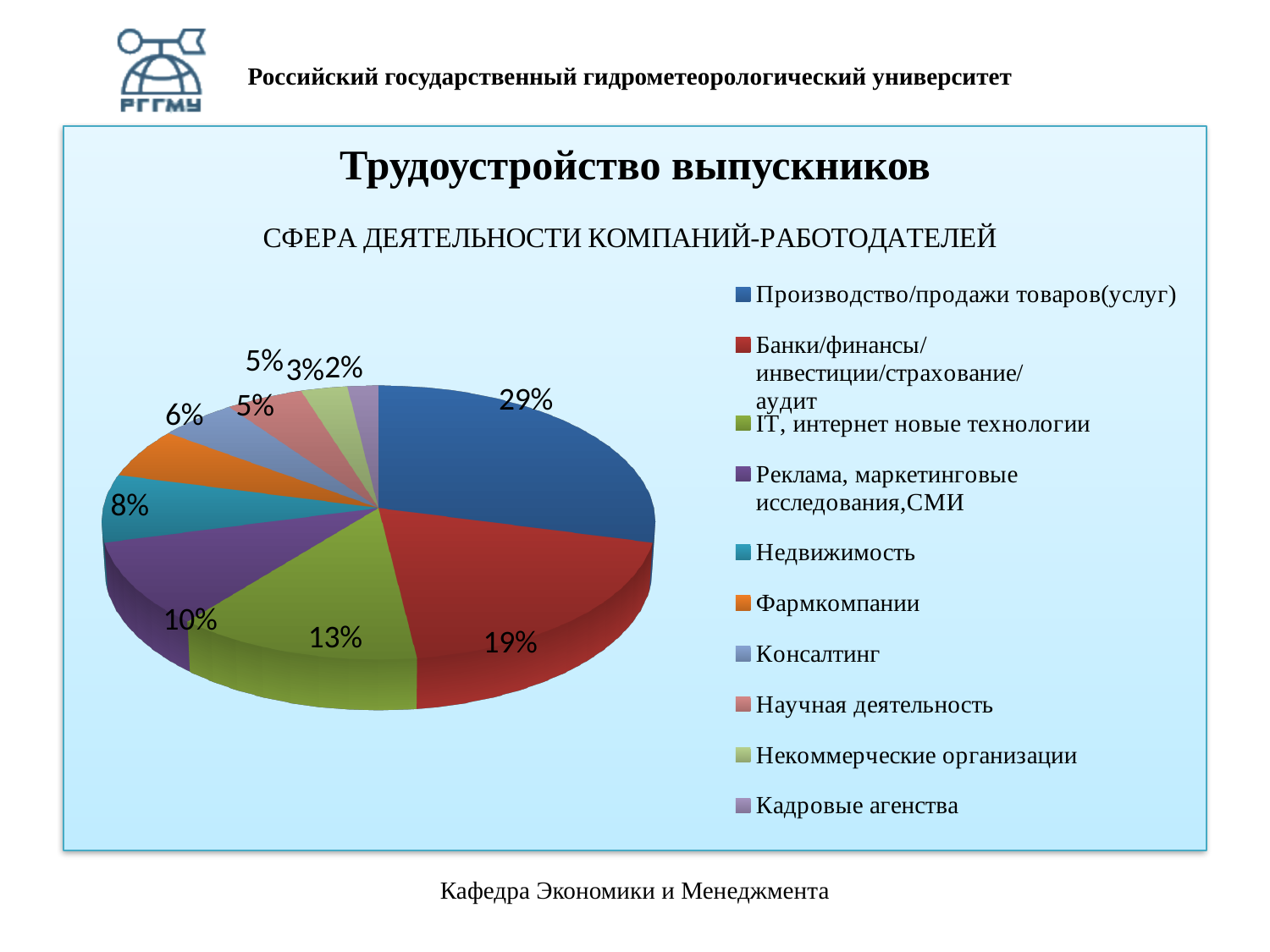
What kind of chart is shown on the slide? pie chart What share of the pie is Производство/продажи товаров(услуг)? 29% Which is larger, the share of Реклама, маркетинговые исследования,СМИ or the share of Фармкомпании? Реклама, маркетинговые исследования,СМИ What share of the pie is Недвижимость? 8% What share of the pie is Кадровые агенства? 2% Which category has the largest share of the pie? Производство/продажи товаров(услуг) What is the title of the chart? СФЕРА ДЕЯТЕЛЬНОСТИ КОМПАНИЙ-РАБОТОДАТЕЛЕЙ How many categories does the legend list? 10 Which category has the smallest share of the pie? Кадровые агенства What is the difference between the shares of Производство/продажи товаров(услуг) and Банки/финансы/инвестиции/страхование/аудит? 10%